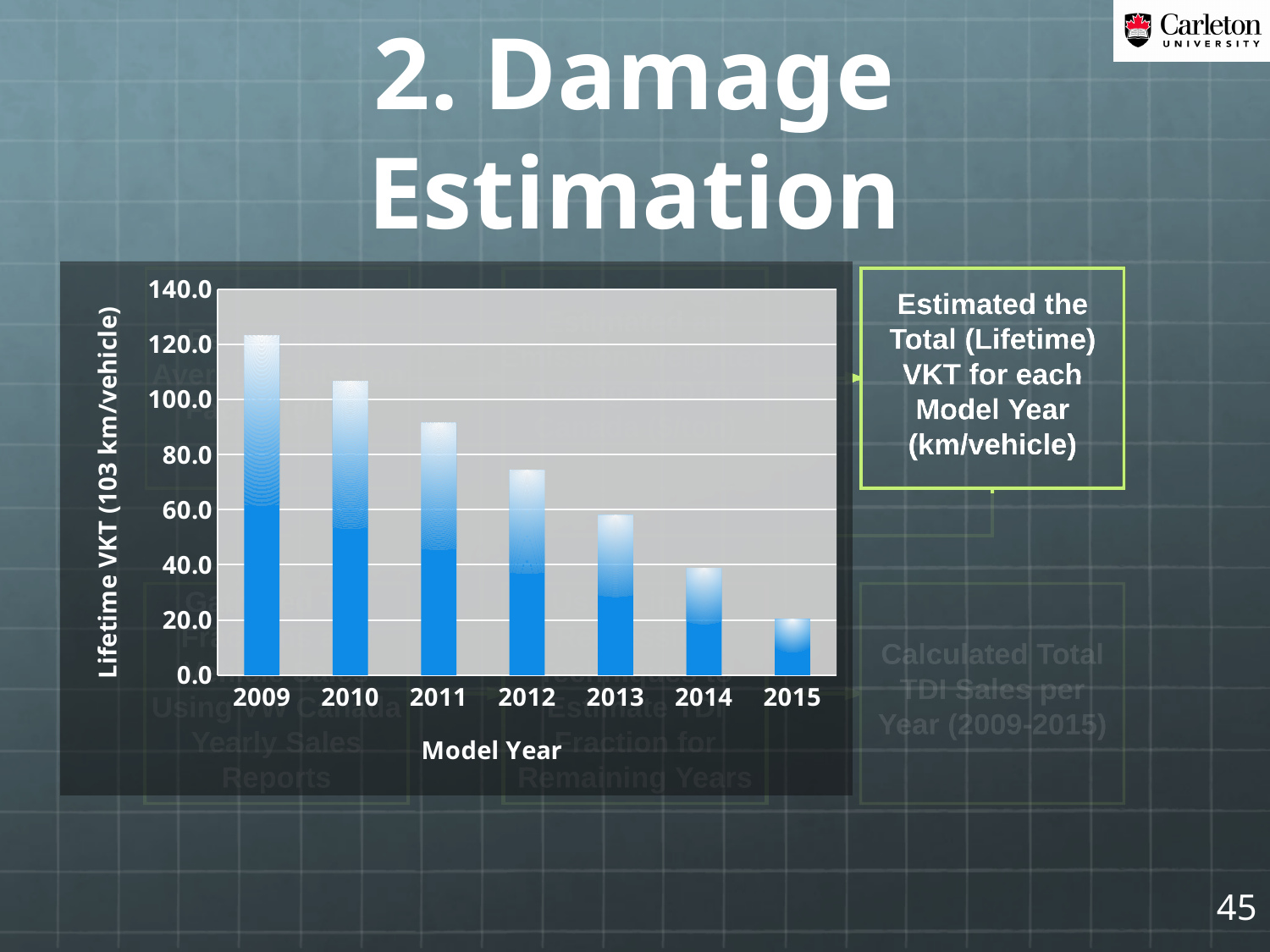
Do the Lifetime VKT values rise or fall as the model year increases from 2009 to 2015? fall How many model years are plotted on the chart? 7 What is the label on the y axis of the chart? Lifetime VKT (103 km/vehicle) Is the Lifetime VKT value for 2009 greater or less than 100.0? greater Which model year has the lowest Lifetime VKT? 2015 What is the label on the x axis of the chart? Model Year Which model year has the highest Lifetime VKT? 2009 Is the Lifetime VKT value for 2011 greater or less than 100.0? less Is the Lifetime VKT value for 2014 greater or less than 20.0? greater Which model year has a larger Lifetime VKT, 2010 or 2013? 2010 What kind of chart is shown on the slide? bar chart